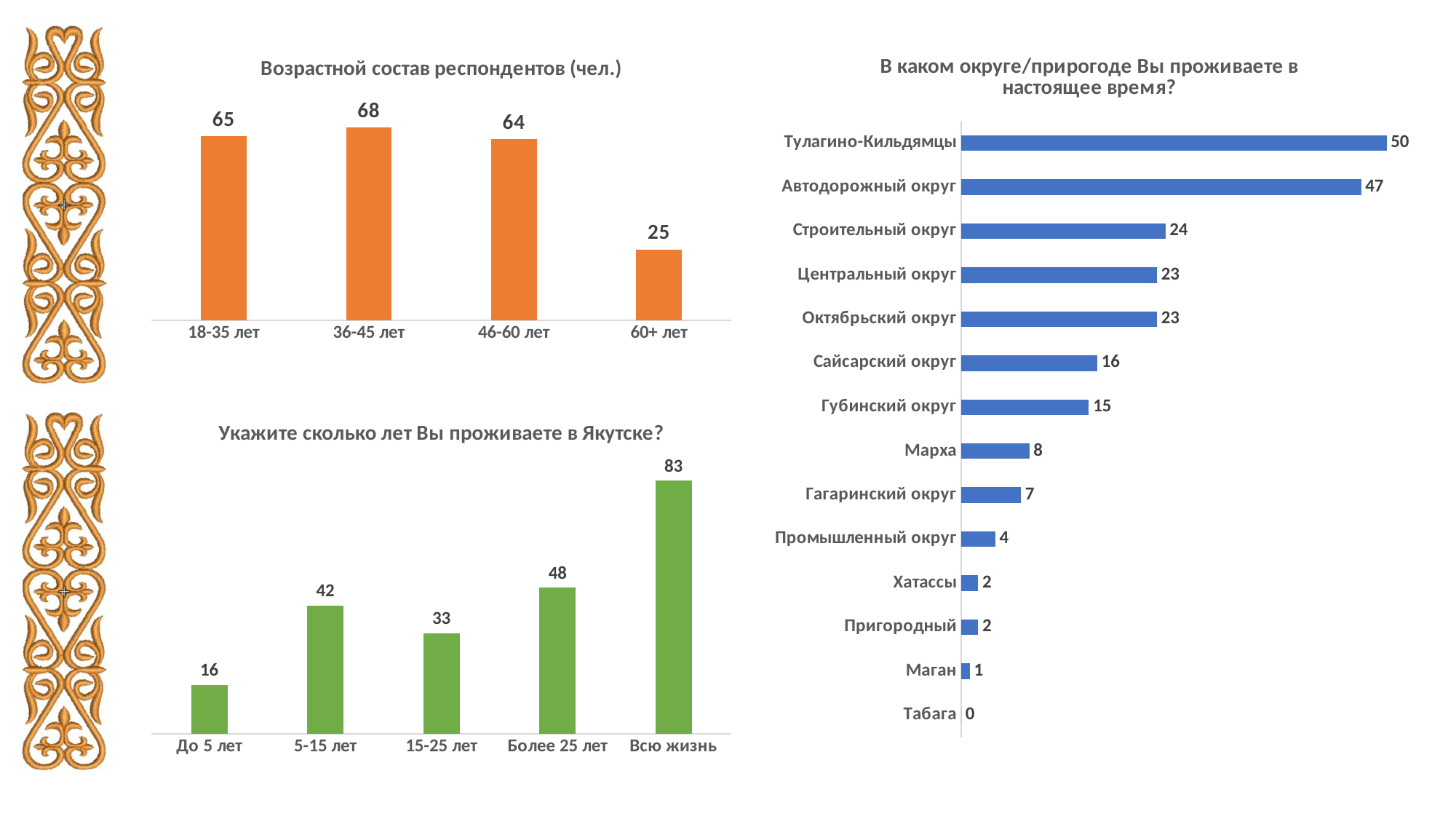
In the chart 'Возрастной состав респондентов (чел.)', what is the value for 36-45 лет? 68 In the chart 'Возрастной состав респондентов (чел.)', which age group has the lowest value? 60+ лет What type of chart is 'В каком округе/пригороде Вы проживаете в настоящее время?'? Bar chart In the chart 'Укажите сколько лет Вы проживаете в Якутске?', which is larger: 5-15 лет or 15-25 лет? 5-15 лет In the chart 'В каком округе/пригороде Вы проживаете в настоящее время?', what is the value for Сайсарский округ? 16 In the chart 'Возрастной состав респондентов (чел.)', how many age categories are shown? 4 In the chart 'Укажите сколько лет Вы проживаете в Якутске?', which category has the highest value? Всю жизнь In the chart 'Возрастной состав респондентов (чел.)', what is the difference between the values for 18-35 лет and 60+ лет? 40 In the chart 'Укажите сколько лет Вы проживаете в Якутске?', what is the value for Всю жизнь? 83 In the chart 'Укажите сколько лет Вы проживаете в Якутске?', what is the difference between Более 25 лет and До 5 лет? 32 In the chart 'В каком округе/пригороде Вы проживаете в настоящее время?', which district has the highest value? Тулагино-Кильдямцы In the chart 'В каком округе/пригороде Вы проживаете в настоящее время?', how many categories are listed? 14